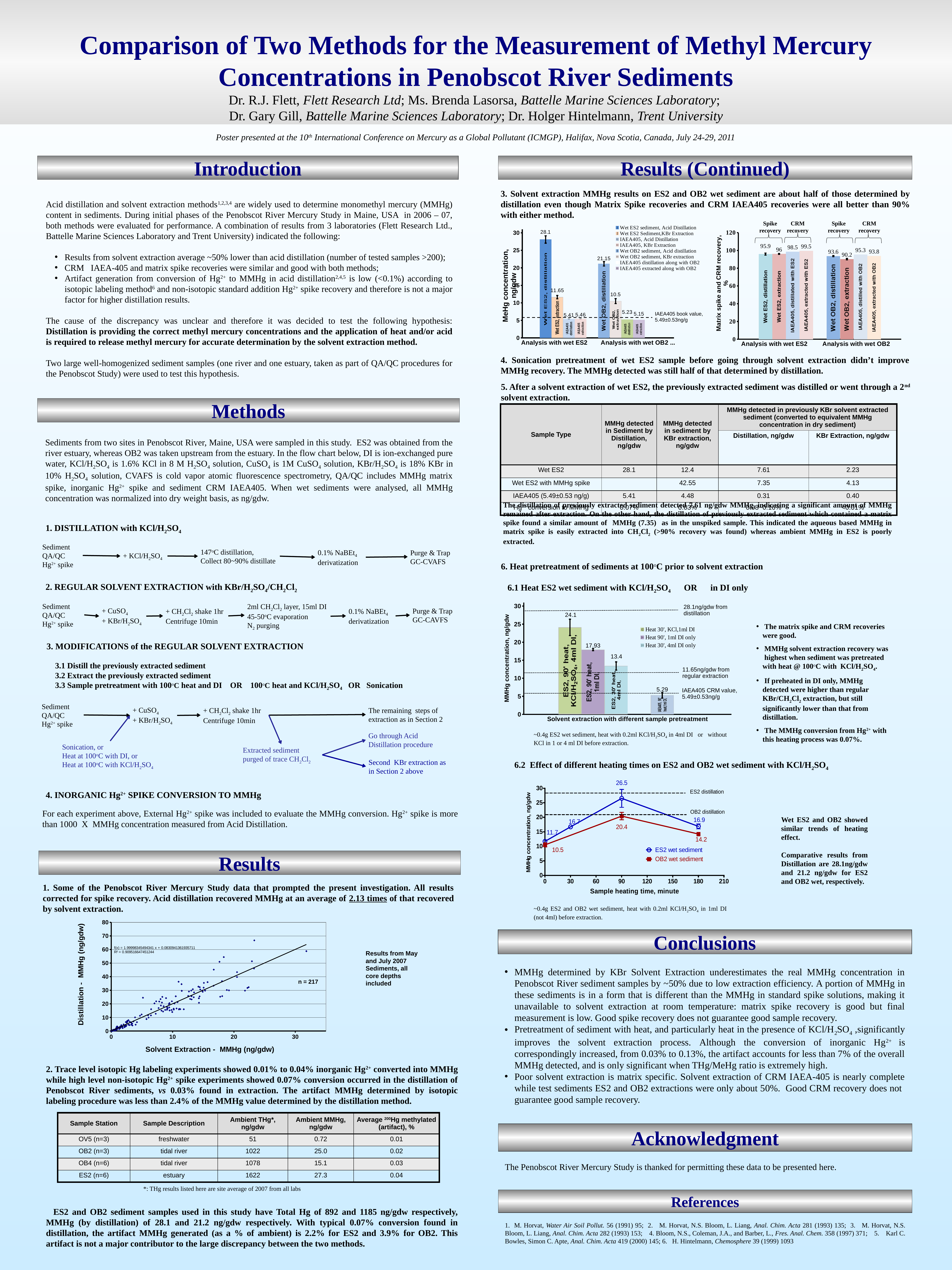
In the MeHg concentration bar chart in section 3 of Results (Continued), which bar is the highest? Wet ES2, distillation In the Matrix spike and CRM recovery bar chart in section 3 of Results (Continued), is the value for Wet ES2 distillation greater or less than 80? greater In the bar chart in section 6.1 (Heat ES2 wet sediment), what is the MMHg concentration for ES2 with 90' heat, KCl/H2SO4, 4 ml DI? 24.1 What type of chart is shown in section 1 of Results, plotting Distillation MMHg against Solvent Extraction MMHg? Scatter plot In the Matrix spike and CRM recovery bar chart in section 3 of Results (Continued), what is the recovery for IAEA405 extracted with ES2? 99.5 In the MeHg concentration bar chart in section 3 of Results (Continued), what is the difference between Wet ES2 distillation and Wet ES2 extraction? 16.45 In the Matrix spike and CRM recovery bar chart in section 3 of Results (Continued), which bar is the lowest? Wet OB2, extraction In the line chart in section 6.2, what is the MMHg concentration for ES2 wet sediment at 90 minutes of heating? 26.5 In the line chart in section 6.2, how many series does the legend list? 2 In the MeHg concentration bar chart in section 3 of Results (Continued), what is the value for Wet ES2 sediment by acid distillation? 28.1 In the MeHg concentration bar chart in section 3 of Results (Continued), what is the value for Wet OB2 sediment by KBr extraction? 10.5 In the bar chart in section 6.1 (Heat ES2 wet sediment), which is larger: ES2 90' heat 1 ml DI or ES2 30' heat 4 ml DI? ES2, 90' heat, 1ml DI